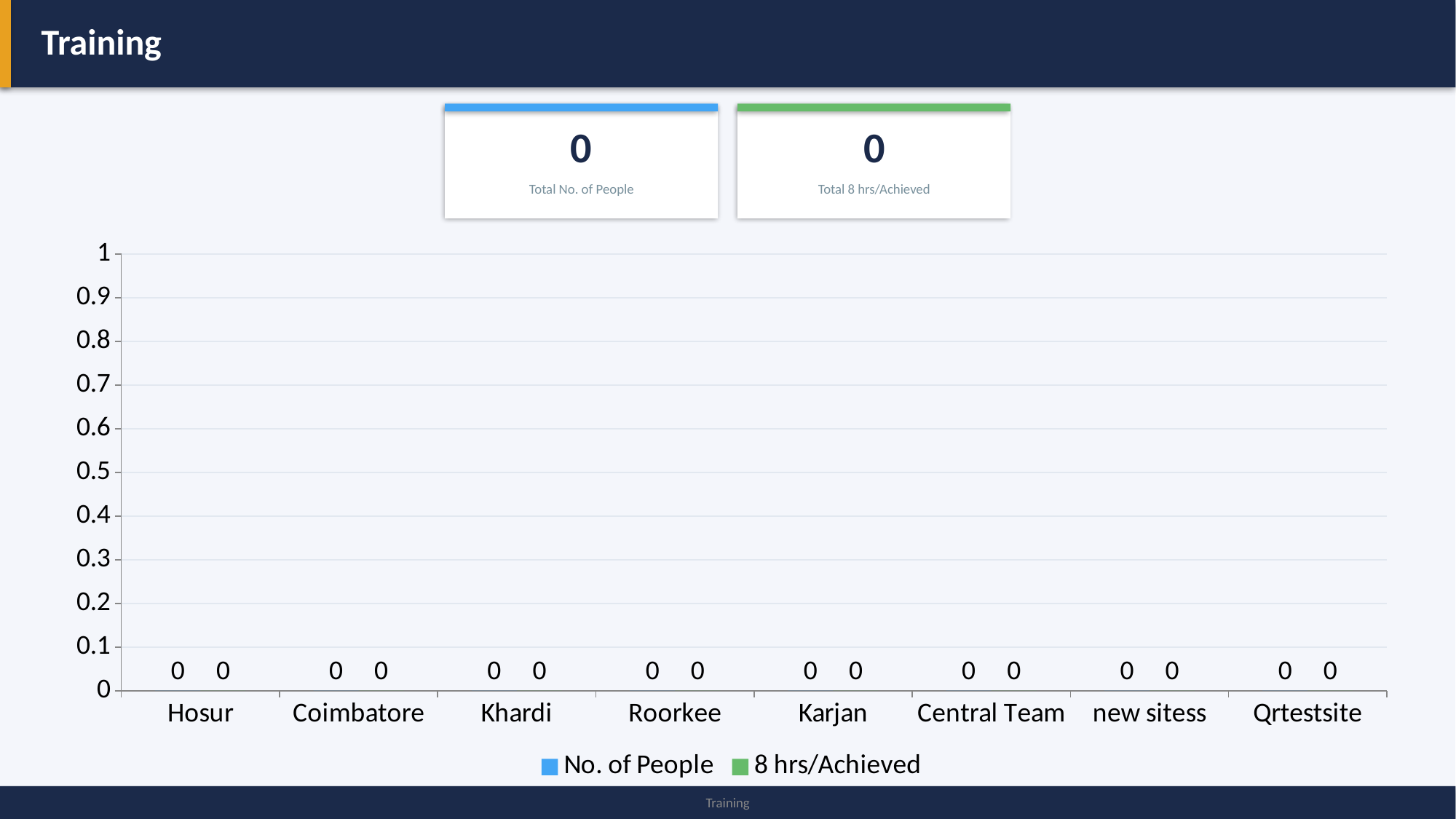
What is the difference between No. of People and 8 hrs/Achieved at Karjan? 0 Do the No. of People values rise, fall, or stay flat across the categories? stay flat How many categories are shown on the x axis of the chart? 8 What is the value shown in the Total 8 hrs/Achieved box? 0 What is the value for No. of People at Hosur? 0 What is the value for No. of People at Central Team? 0 What kind of chart is shown on the slide? bar chart Which colour represents the 8 hrs/Achieved series in the legend? green What is the value for 8 hrs/Achieved at Coimbatore? 0 What is the value for 8 hrs/Achieved at Qrtestsite? 0 How many series does the chart legend list? 2 What is the value shown in the Total No. of People box? 0